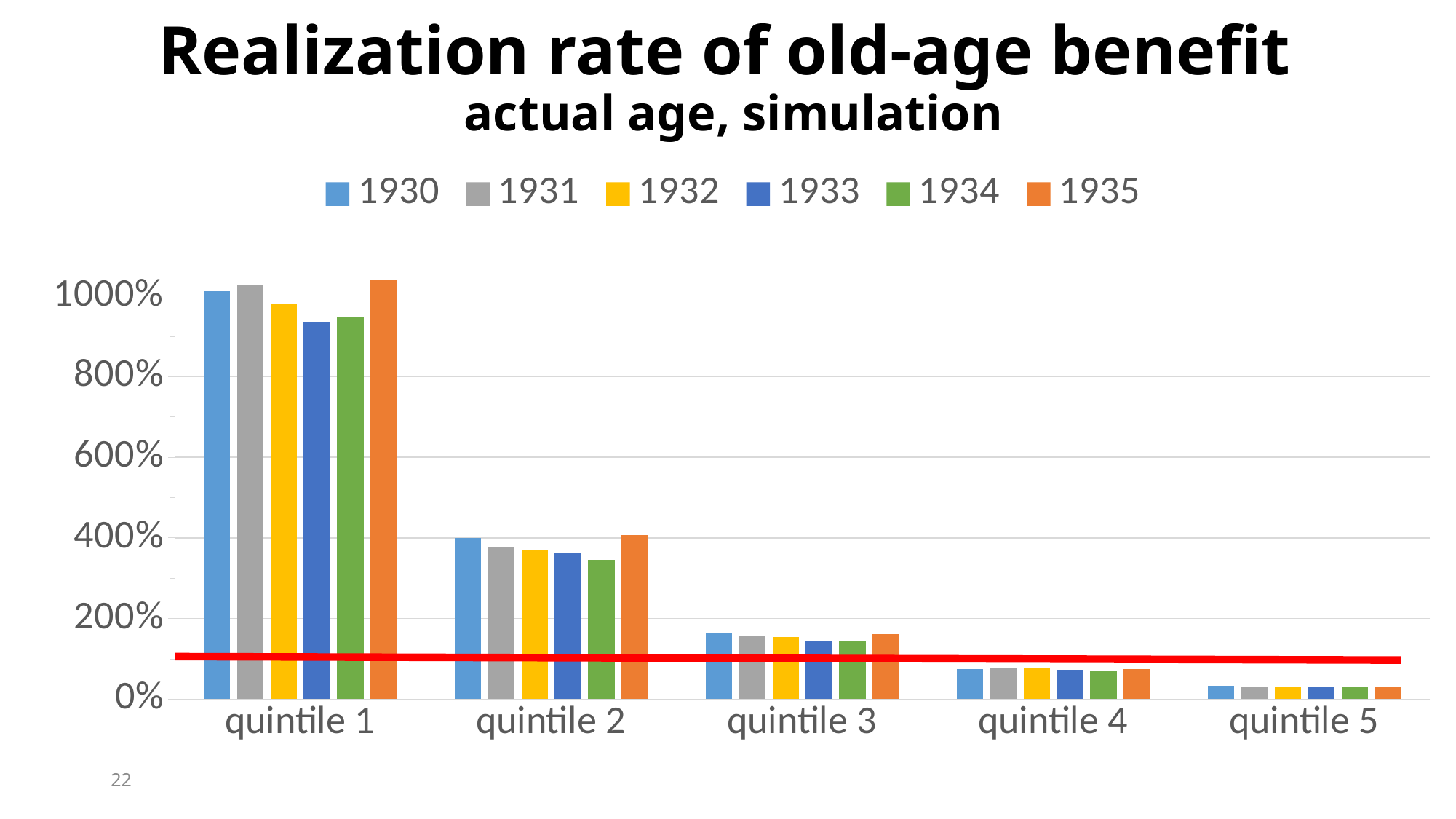
Is the value for 1935 in quintile 1 greater or less than 1000%? greater Do the values rise or fall from quintile 1 to quintile 5? fall How many quintile categories are shown on the x axis? 5 Which quintile has the shortest bars? quintile 5 Is the value for 1934 in quintile 2 greater or less than 400%? less What kind of chart is shown on the slide? bar chart Is the value for 1932 in quintile 4 greater or less than 200%? less Which quintile has the tallest bars? quintile 1 In quintile 2, which is larger, the value for 1935 or the value for 1934? 1935 How many series does the legend list? 6